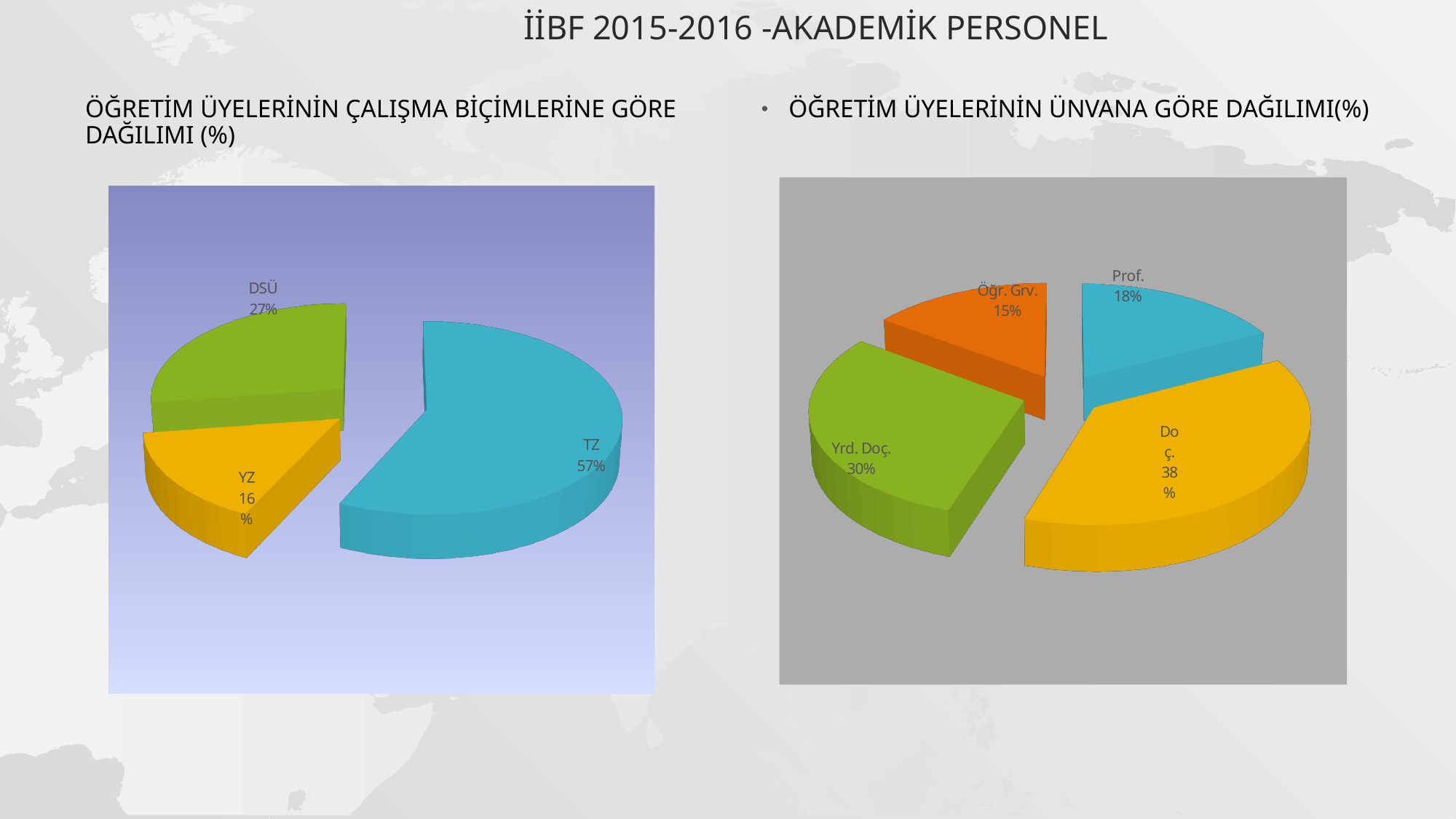
In the left pie chart, how many slices are there? 3 In the left pie chart, what is the value for DSÜ? 27% In the right pie chart, which category has the smallest share? Öğr. Grv. In the right pie chart (ÖĞRETİM ÜYELERİNİN ÜNVANA GÖRE DAĞILIMI), what is the value for Yrd. Doç.? 30% In the right pie chart, what is the value for Prof.? 18% In the left pie chart, what is the value for YZ? 16% In the left pie chart, which category has the smallest share? YZ In the left pie chart, which category has the largest share? TZ In the right pie chart, which category has the largest share? Doç. What type of chart is shown on the right side of the slide? Pie chart In the left pie chart (ÖĞRETİM ÜYELERİNİN ÇALIŞMA BİÇİMLERİNE GÖRE DAĞILIMI), what is the value for TZ? 57% In the left pie chart, what is the difference between the TZ and DSÜ values? 30%